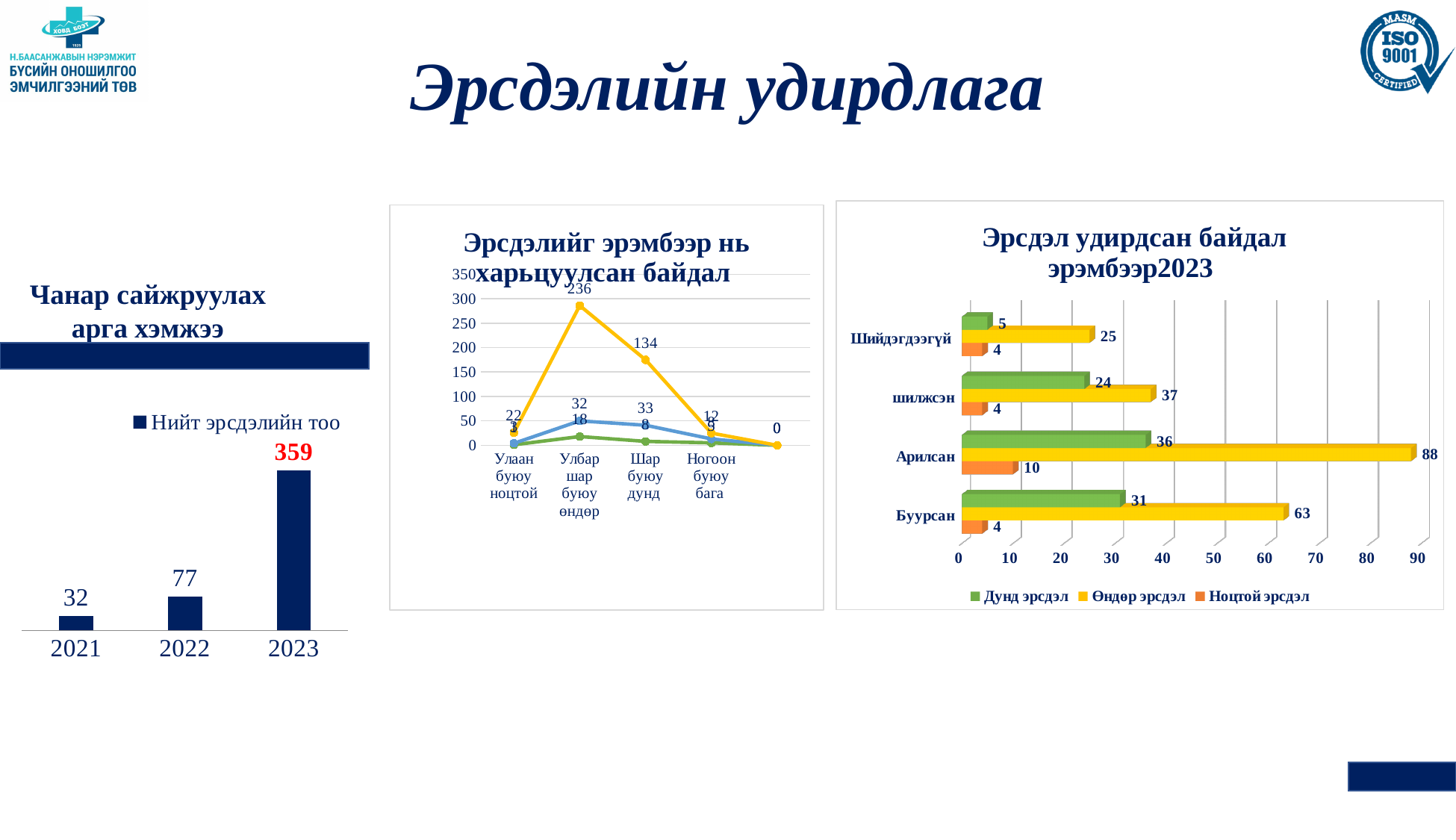
In the right chart 'Эрсдэл удирдсан байдал эрэмбээр2023', which category has the highest Өндөр эрсдэл value? Арилсан In the right chart 'Эрсдэл удирдсан байдал эрэмбээр2023', what is the value of Өндөр эрсдэл for Арилсан? 88 In the left chart 'Чанар сайжруулах арга хэмжээ', do the values rise or fall from 2021 to 2023? rise In the left chart 'Чанар сайжруулах арга хэмжээ', what is the value for 2023? 359 What kind of chart is the left chart 'Чанар сайжруулах арга хэмжээ'? bar chart What kind of chart is the middle chart 'Эрсдэлийг эрэмбээр нь харьцуулсан байдал'? line chart In the middle chart 'Эрсдэлийг эрэмбээр нь харьцуулсан байдал', what is the highest value labelled on the yellow line? 236 In the left chart 'Чанар сайжруулах арга хэмжээ', what is the difference between the 2022 and 2021 values? 45 In the left chart 'Чанар сайжруулах арга хэмжээ', what is the value for 2021? 32 In the right chart 'Эрсдэл удирдсан байдал эрэмбээр2023', what is the value of Ноцтой эрсдэл for Арилсан? 10 In the right chart 'Эрсдэл удирдсан байдал эрэмбээр2023', what is the difference between the Өндөр эрсдэл values for Буурсан and Шийдэгдээгүй? 38 In the right chart 'Эрсдэл удирдсан байдал эрэмбээр2023', how many series does the legend list? 3